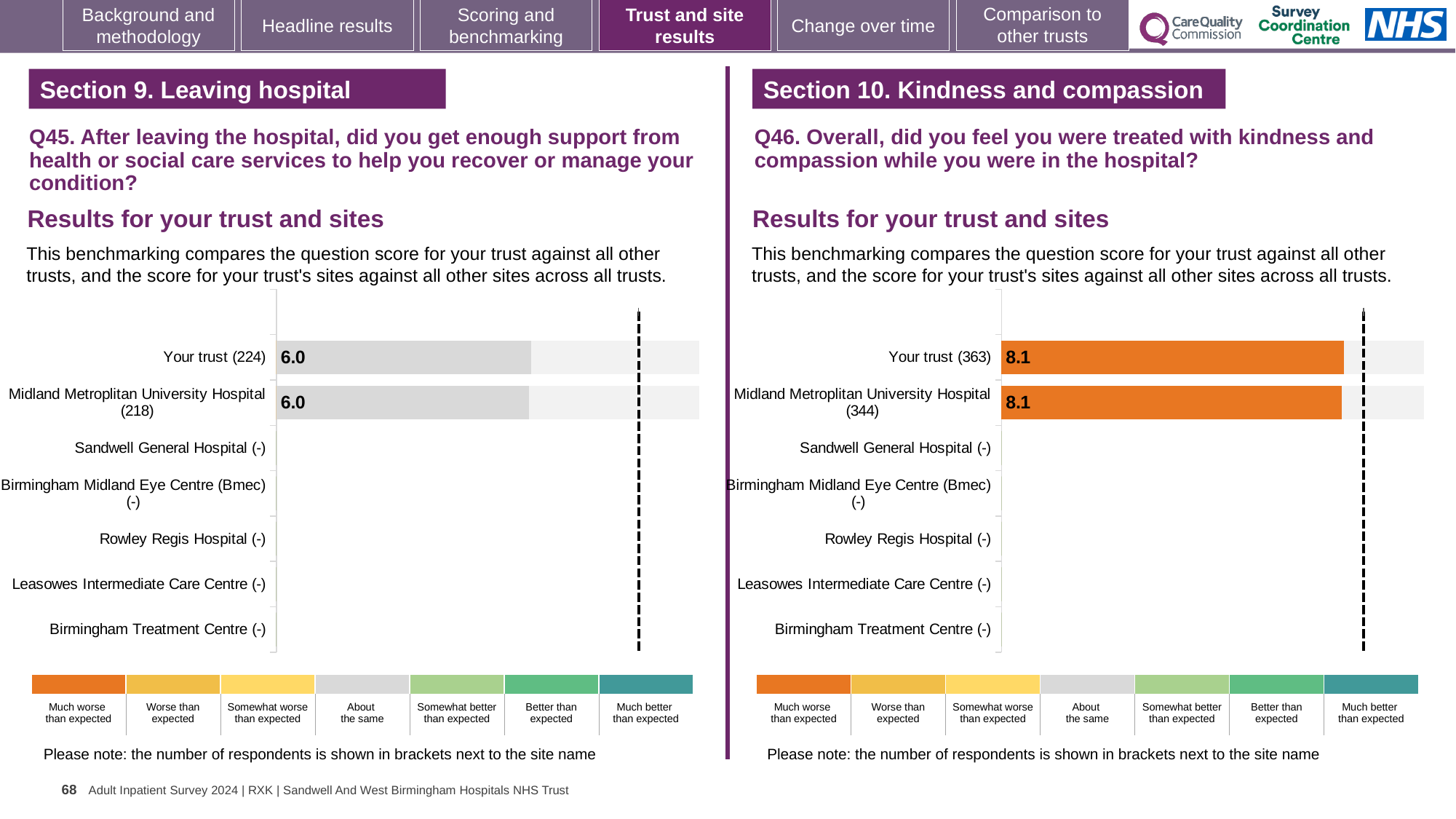
In the Q46 chart on the right, what is the score for Your trust (363)? 8.1 How many site categories are listed on the y axis of the Q46 chart on the right? 7 In the Q45 chart on the left, what is the difference between the score for Your trust (224) and the score for Midland Metropolitan University Hospital (218)? 0.0 In the Q46 chart on the right, what is the score for Midland Metropolitan University Hospital (344)? 8.1 In the Q45 chart on the left, how many sites have a plotted bar? 2 In the Q46 chart on the right, what colour is the bar for Your trust (363)? Orange In the Q45 chart on the left, what is the score for Your trust (224)? 6.0 According to the colour key below the Q45 chart on the left, which benchmark category does the grey bar colour represent? About the same In the Q46 chart on the right, what is the difference between the score for Your trust (363) and the score for Midland Metropolitan University Hospital (344)? 0.0 What kind of chart is the Q46 chart on the right? Bar chart How many site categories are listed on the y axis of the Q45 chart on the left? 7 In the Q45 chart on the left, what is the score for Midland Metropolitan University Hospital (218)? 6.0